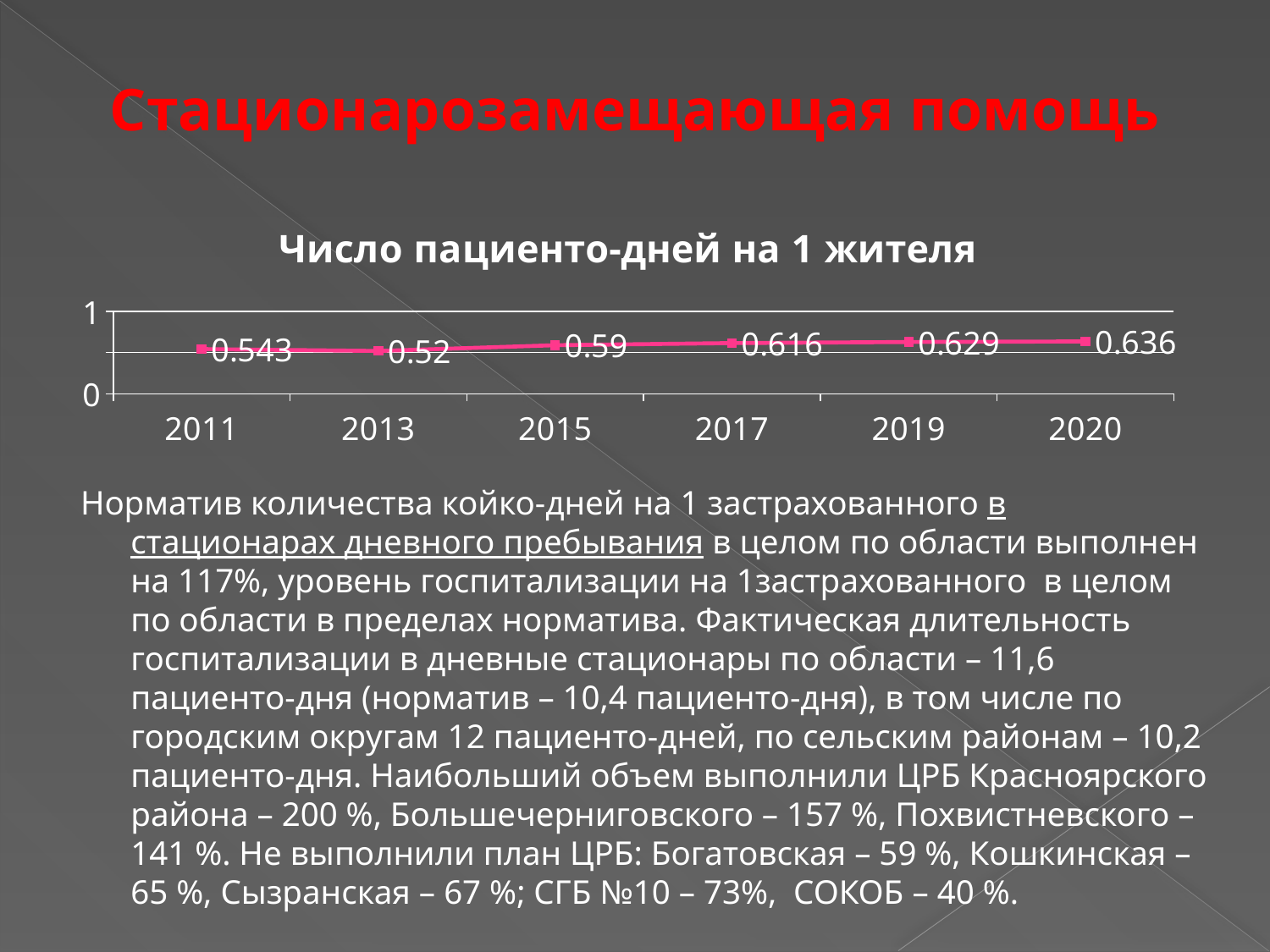
Which is larger in the chart 'Число пациенто-дней на 1 жителя': the value for 2017 or the value for 2013? 2017 What is the value for 2011 in the chart 'Число пациенто-дней на 1 жителя'? 0.543 What is the title of the chart on the slide? Число пациенто-дней на 1 жителя Is the value for 2019 in the chart 'Число пациенто-дней на 1 жителя' greater or less than 1? less Which year has the highest value in the chart 'Число пациенто-дней на 1 жителя'? 2020 How many years are plotted in the chart 'Число пациенто-дней на 1 жителя'? 6 Do the values in the chart 'Число пациенто-дней на 1 жителя' generally rise or fall from 2013 to 2020? rise Which year has the lowest value in the chart 'Число пациенто-дней на 1 жителя'? 2013 What kind of chart is 'Число пациенто-дней на 1 жителя'? line chart What is the value for 2015 in the chart 'Число пациенто-дней на 1 жителя'? 0.59 What is the value for 2020 in the chart 'Число пациенто-дней на 1 жителя'? 0.636 What is the difference between the values for 2020 and 2011 in the chart 'Число пациенто-дней на 1 жителя'? 0.093